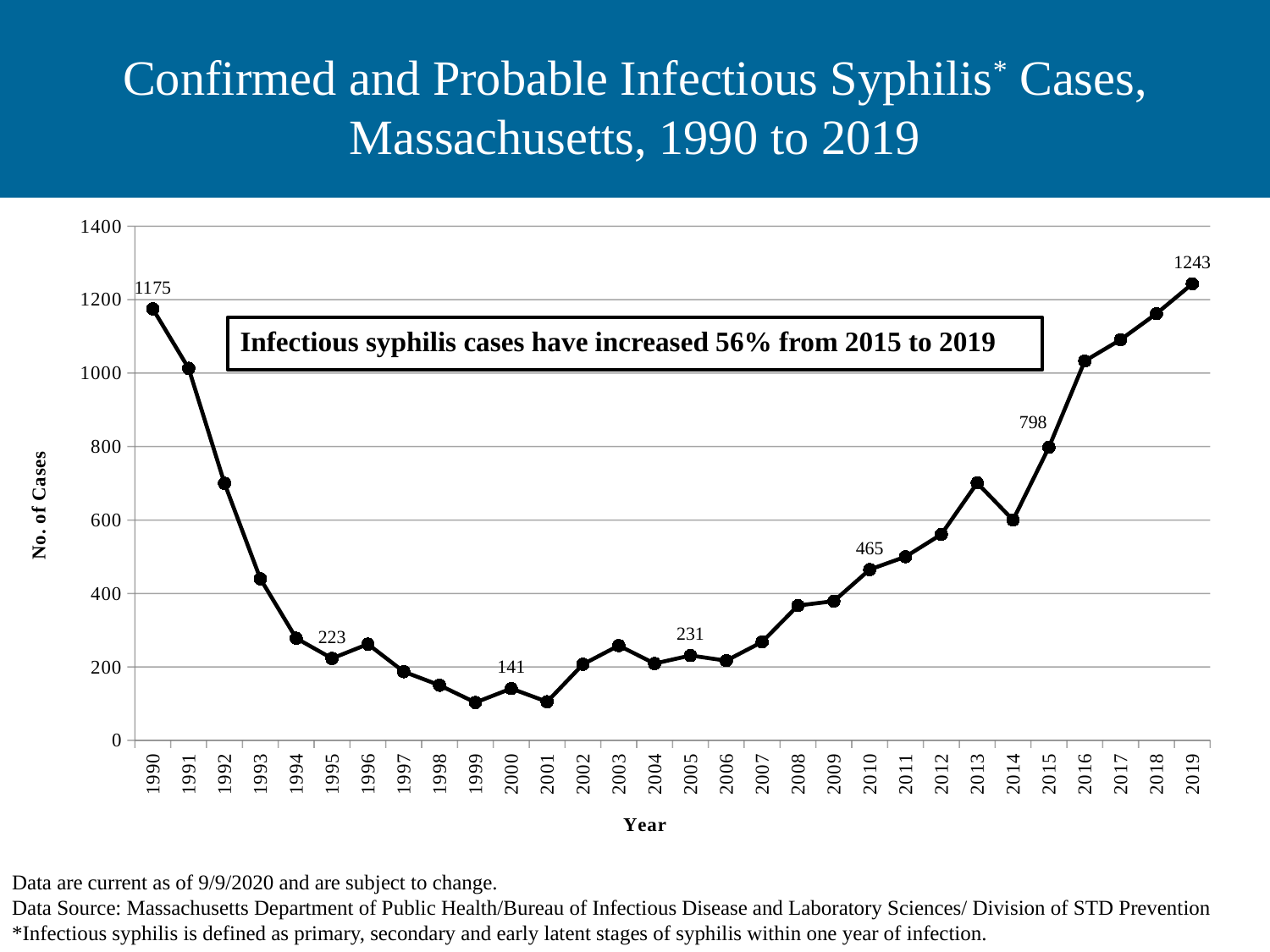
What is the number of cases shown for 2019? 1243 Which year has the highest number of cases on the chart? 2019 How many syphilis cases were reported in Massachusetts in 1990? 1175 What value is labeled for the year 2000? 141 How many cases are shown for 2015? 798 Which year had more cases, 2010 or 2005? 2010 What is the difference in cases between 2019 and 2015? 445 Is the value for 2008 greater or less than 400? less What kind of chart is shown on the slide? line chart How many years are plotted on the x axis? 30 Is the value for 1992 greater or less than 600? greater Do the number of cases rise or fall from 1990 to 1999? fall